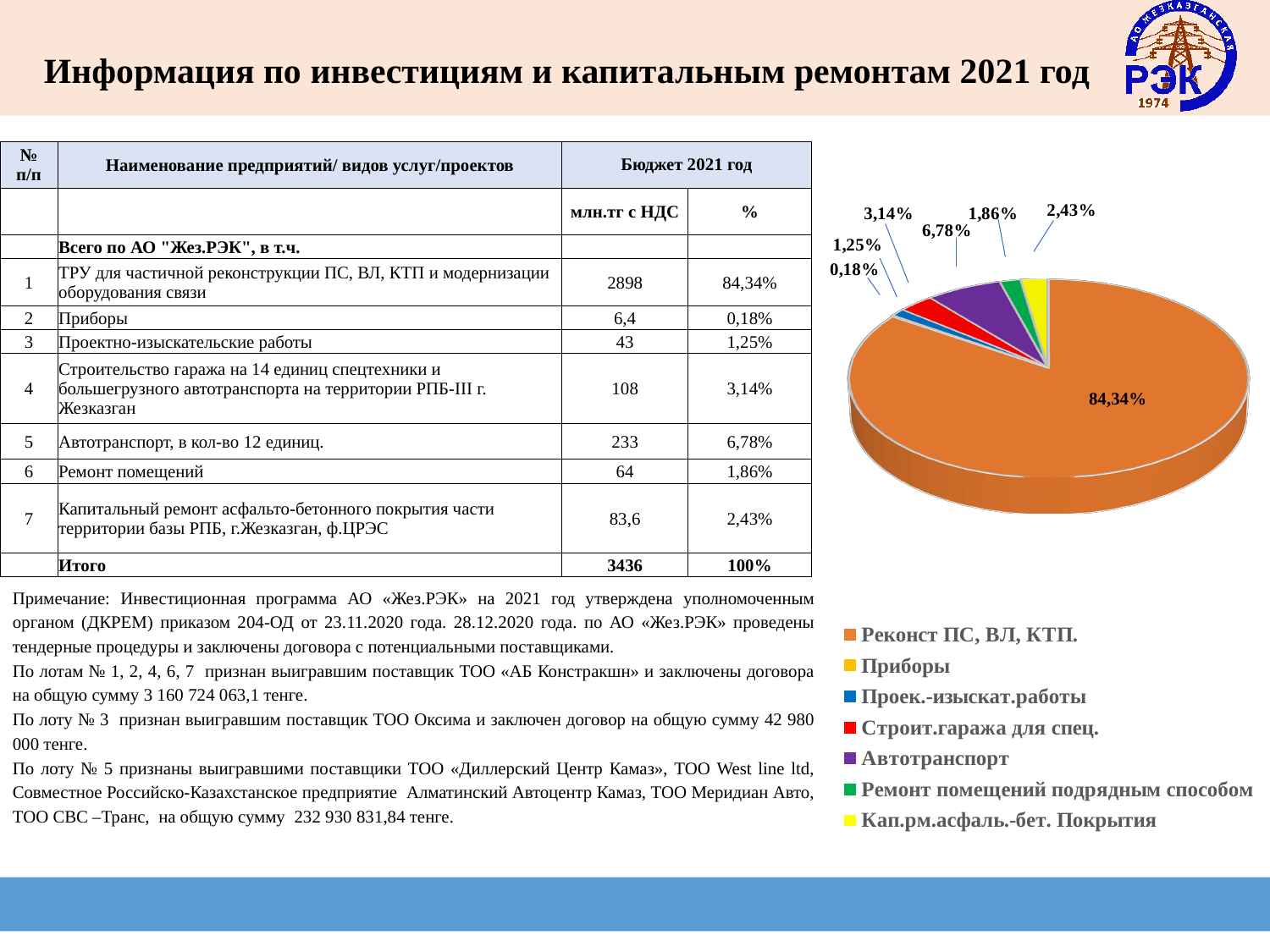
What share of the pie does the slice for Реконст ПС, ВЛ, КТП. represent? 84,34% What is the value shown for Строит.гаража для спец. in the pie chart? 3,14% Which category has the smallest slice in the pie chart? Приборы What is the value shown for Приборы in the pie chart? 0,18% What colour is the slice for Автотранспорт in the pie chart? purple What kind of chart is shown on the right side of the slide? pie chart How many slices does the pie chart have? 7 How many entries does the legend of the pie chart list? 7 What is the difference between the shares for Автотранспорт and Строит.гаража для спец. in the pie chart? 3,64% What is the value shown for Автотранспорт in the pie chart? 6,78% Which category has the largest slice in the pie chart? Реконст ПС, ВЛ, КТП. Which is larger in the pie chart: Автотранспорт or Кап.рм.асфаль.-бет. Покрытия? Автотранспорт